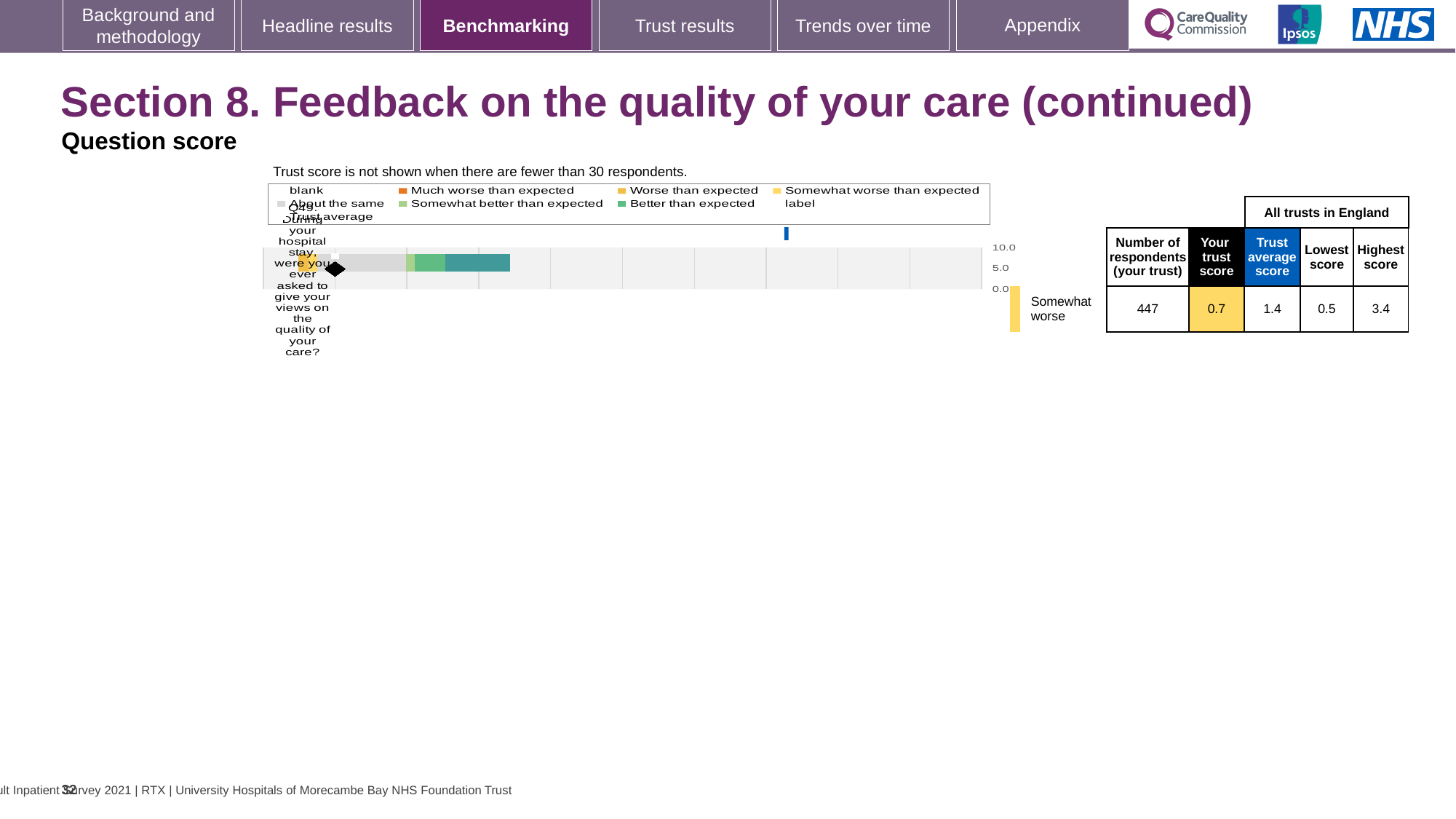
What is the lowest score for Q49 among all trusts in England? 0.5 How many questions (categories) are plotted on the benchmarking chart? 1 What is the difference between the highest and lowest scores for Q49 across all trusts in England? 2.9 What kind of chart is used to show the Q49 benchmarking result? bar chart What is the highest score for Q49 among all trusts in England? 3.4 What is the trust score for Q49 shown in the 'Your trust score' column? 0.7 Which is larger for Q49: the trust's own score or the trust average score? Trust average score What is the difference between the trust average score and the trust's own score for Q49? 0.7 What benchmark category is the trust's Q49 score assigned to, as labelled next to the chart? Somewhat worse What is the trust average score for Q49 across all trusts in England? 1.4 Which question is plotted on the benchmarking chart? Q49. During your hospital stay, were you ever asked to give your views on the quality of your care? How many respondents from the trust answered Q49? 447